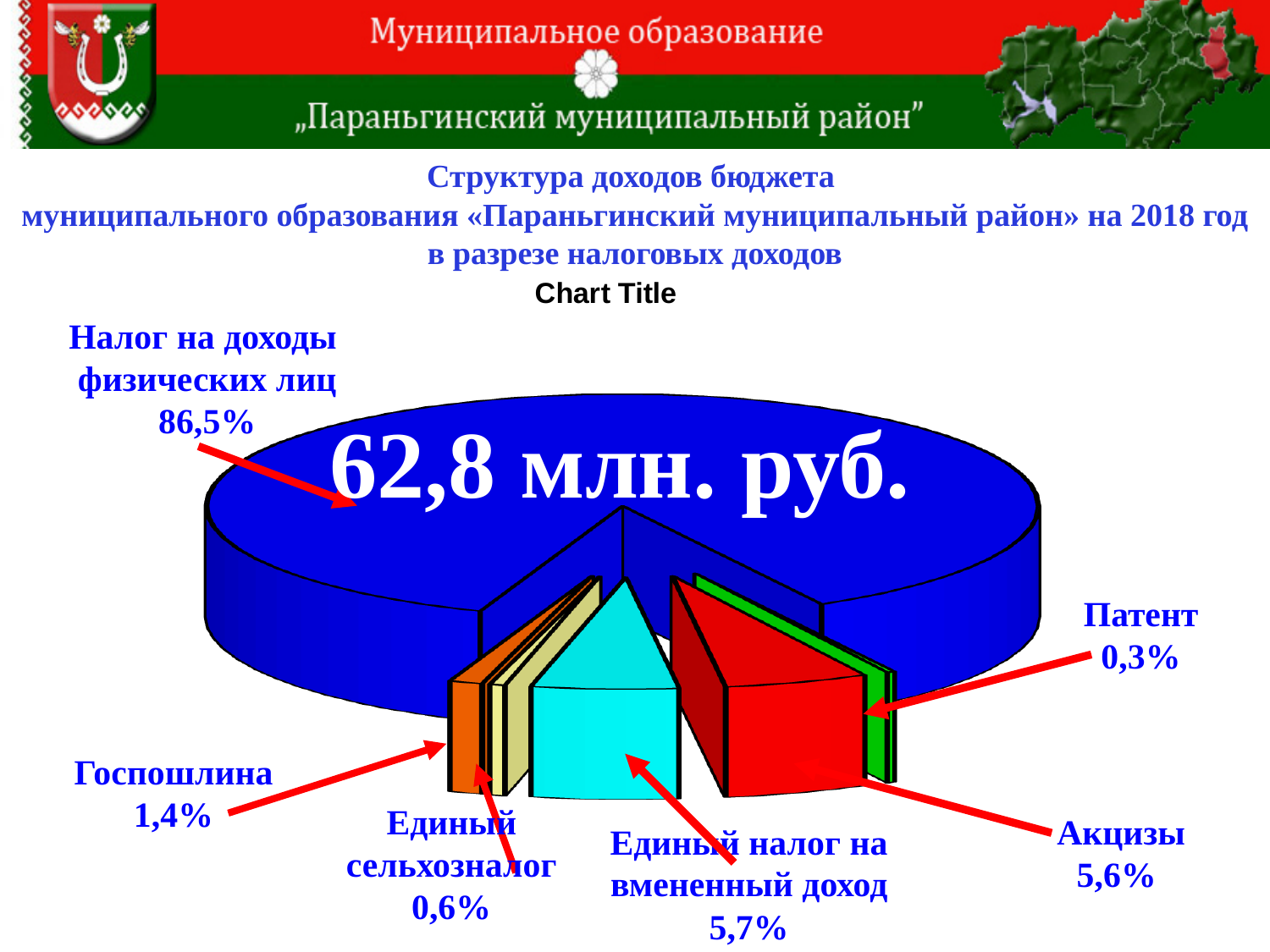
What is the value shown for «Акцизы»? 5,6% What share of the pie does «Налог на доходы физических лиц» have? 86,5% Which category has the largest share of the pie? Налог на доходы физических лиц What is the difference between the shares of «Госпошлина» and «Единый сельхозналог»? 0,8% What kind of chart is shown on the slide? pie chart What is the value shown for «Единый налог на вмененный доход»? 5,7% What is the value shown for «Патент»? 0,3% Which category has the smallest share of the pie? Патент What is the value shown for «Госпошлина»? 1,4% How many categories (slices) does the pie chart have? 6 What total amount is printed on the pie chart? 62,8 млн. руб. Which is larger: the share of «Акцизы» or the share of «Госпошлина»? Акцизы